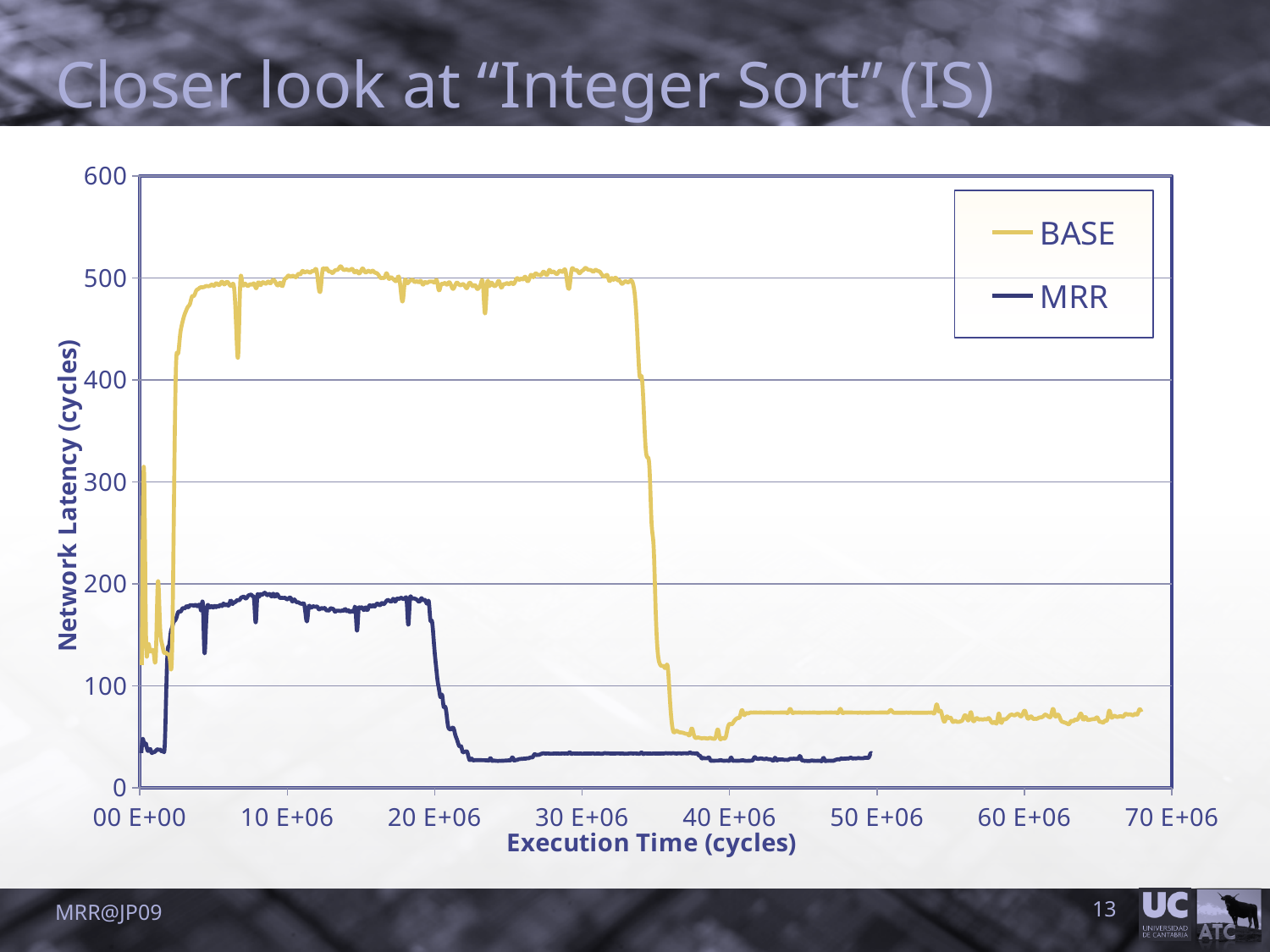
Which series extends further along the execution time axis, BASE or MRR? BASE Is the BASE network latency at 20 E+06 cycles greater or less than 400? greater What kind of chart is shown on the slide? line chart At 45 E+06 execution cycles, which series has the higher network latency, BASE or MRR? BASE How many series does the legend list? 2 Is the BASE network latency at 50 E+06 cycles greater or less than 100? less Does the BASE network latency rise or fall between 30 E+06 and 40 E+06 execution cycles? fall Is the MRR network latency at 10 E+06 cycles greater or less than 100? greater At 20 E+06 execution cycles, which series has the higher network latency, BASE or MRR? BASE What are the two series named in the legend? BASE and MRR What is the label of the vertical axis? Network Latency (cycles)